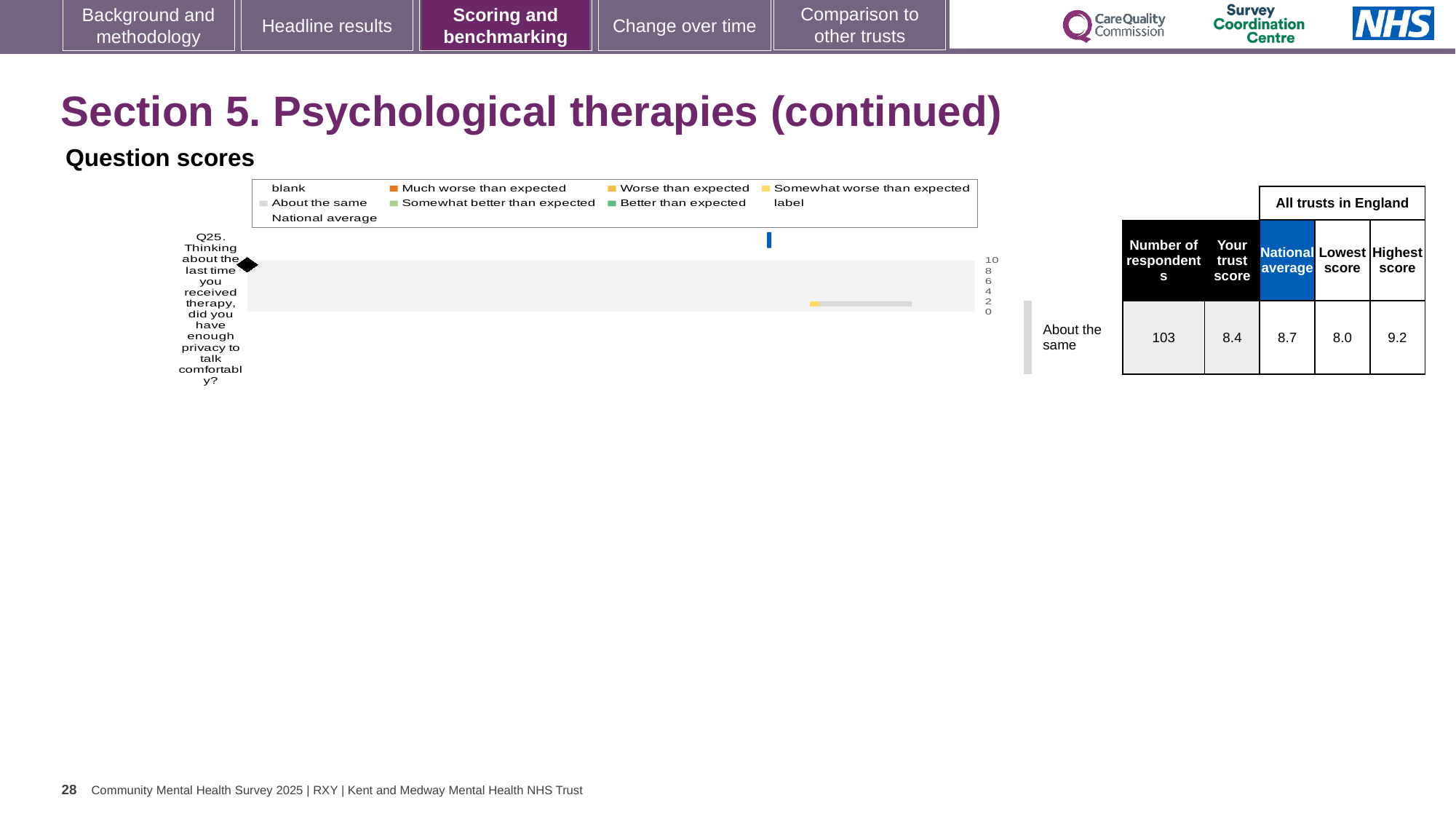
Which question is plotted on the chart? Q25. Thinking about the last time you received therapy, did you have enough privacy to talk comfortably? In the table beside the chart, what is the national average for Q25? 8.7 In the table beside the chart, which is larger for Q25: your trust score or the national average? National average In the table beside the chart, what is the number of respondents for Q25? 103 In the table beside the chart, what is the lowest score among all trusts in England for Q25? 8.0 What kind of chart is shown under 'Question scores'? bar chart Which legend entry is shown with an orange marker? Much worse than expected In the table beside the chart, what is the highest score among all trusts in England for Q25? 9.2 What benchmark category label is shown next to the bar for Q25? About the same How many questions (categories) are plotted on the chart? 1 In the table beside the chart, what is 'Your trust score' for Q25? 8.4 How many entries does the chart legend list? 9